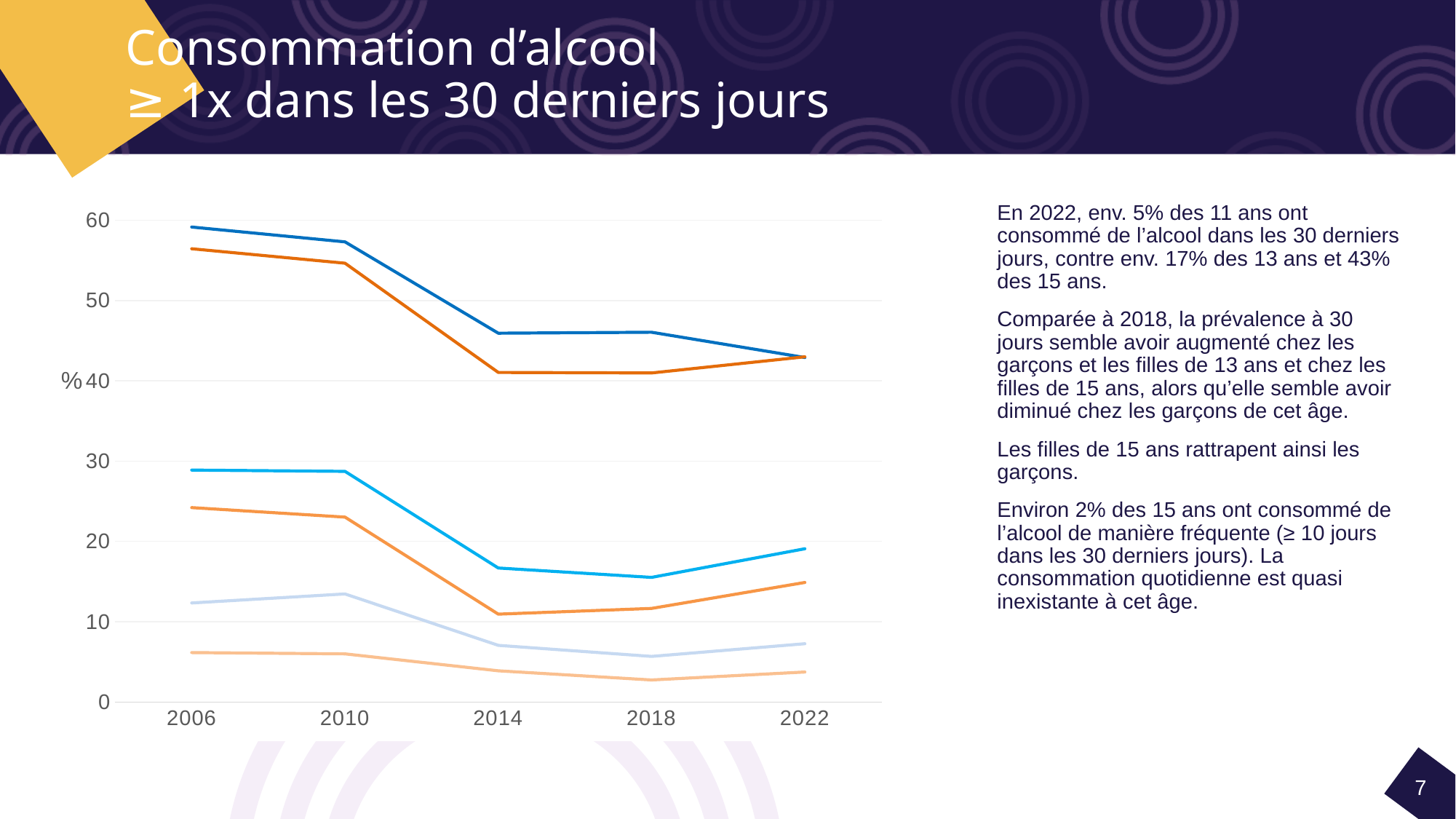
Is the value of the topmost line in 2006 greater or less than 50? greater Is the value of the topmost line in 2022 greater or less than 40? greater Is the value of the lowest line in 2006 greater or less than 10? less How many lines are plotted on the chart? 6 How many years are shown on the x axis of the chart? 5 Does the topmost line on the chart rise or fall between 2006 and 2022? fall What kind of chart is shown on the slide? line chart What unit is shown on the y axis of the chart? % Does the lowest line on the chart rise or fall between 2006 and 2018? fall For the topmost line, is the value in 2006 or in 2022 larger? 2006 What is the first year shown on the x axis of the chart? 2006